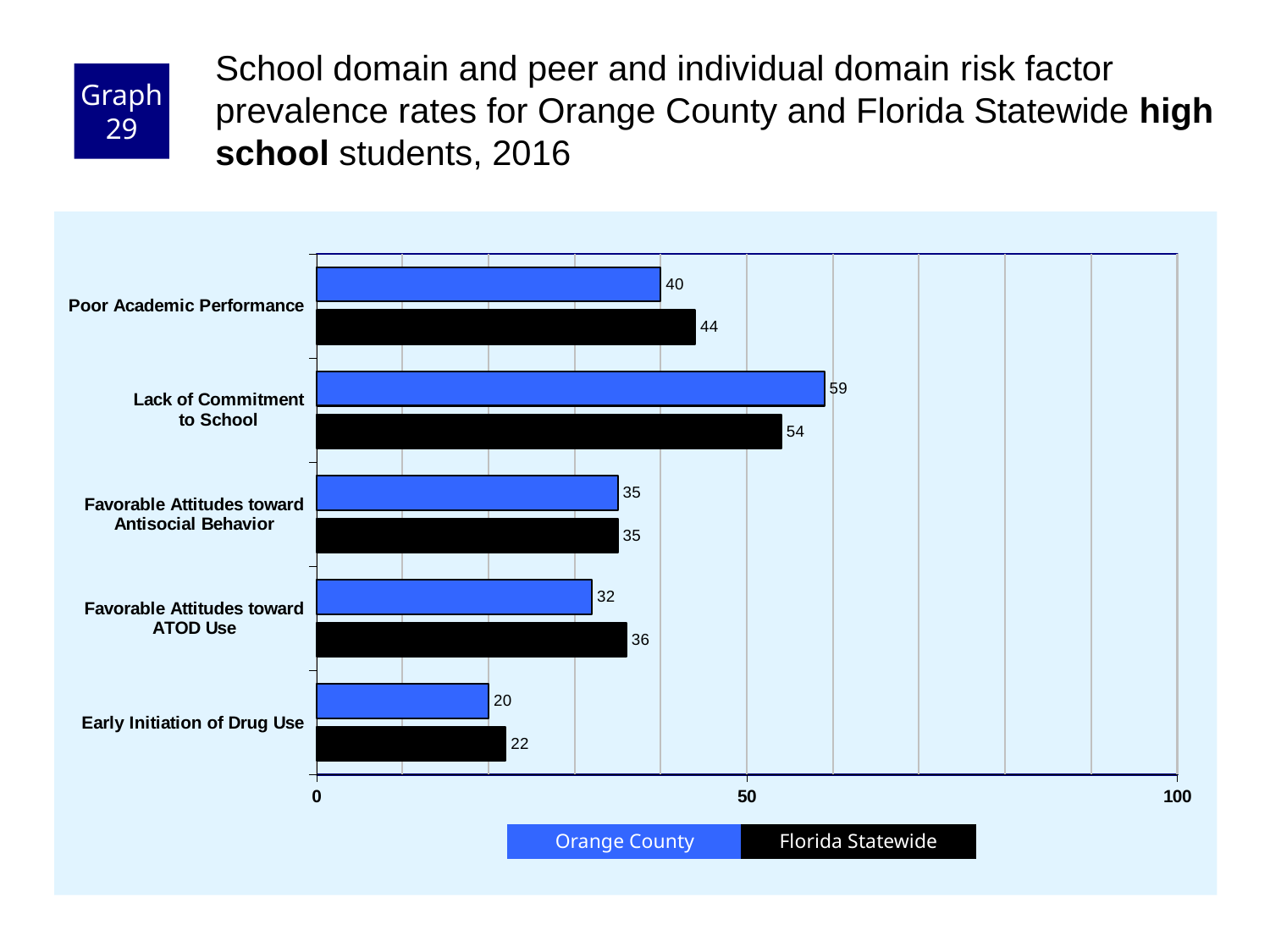
Which colour represents Florida Statewide in the legend? black Which risk factor has the highest Orange County value? Lack of Commitment to School What is the difference between the Florida Statewide and Orange County values for Favorable Attitudes toward ATOD Use? 4 For Lack of Commitment to School, which is larger: the Orange County value or the Florida Statewide value? Orange County Which risk factor has the lowest Florida Statewide value? Early Initiation of Drug Use How many risk factor categories are shown on the chart? 5 Is the Orange County value for Lack of Commitment to School greater or less than 50? greater What is the Florida Statewide value for Poor Academic Performance? 44 What is the Orange County value for Lack of Commitment to School? 59 What kind of chart is shown on the slide? bar chart What is the Orange County value for Early Initiation of Drug Use? 20 How many series does the legend list? 2